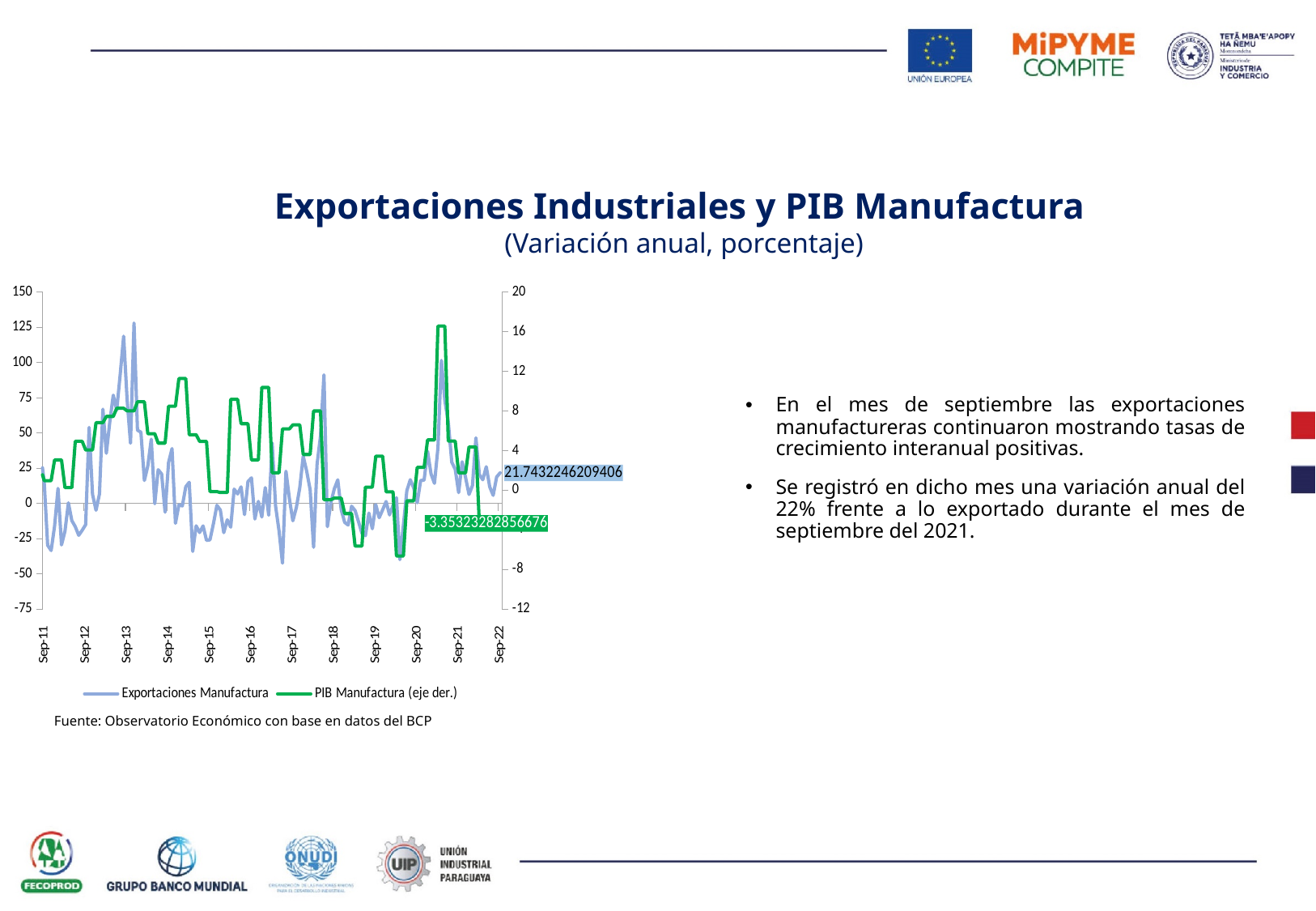
Is the lowest value of the PIB Manufactura (eje der.) series around Sep-19 greater or less than -4 on the right axis? less What kind of chart is shown on the slide? line chart Is the peak value of the PIB Manufactura (eje der.) series around Sep-21 greater or less than 12 on the right axis? greater What are the two series named in the chart legend? Exportaciones Manufactura; PIB Manufactura (eje der.) What is the data label shown for the last point of the PIB Manufactura (eje der.) series? -3.35323282856676 How many date labels are shown along the x axis of the chart? 12 What is the data label shown for the last point of the Exportaciones Manufactura series? 21.7432246209406 How many series does the chart legend list? 2 Is the peak value of the Exportaciones Manufactura series around Sep-13 greater or less than 100 on the left axis? greater Which of the two labeled end values is larger, Exportaciones Manufactura or PIB Manufactura (eje der.)? Exportaciones Manufactura What is the title of the chart? Exportaciones Industriales y PIB Manufactura